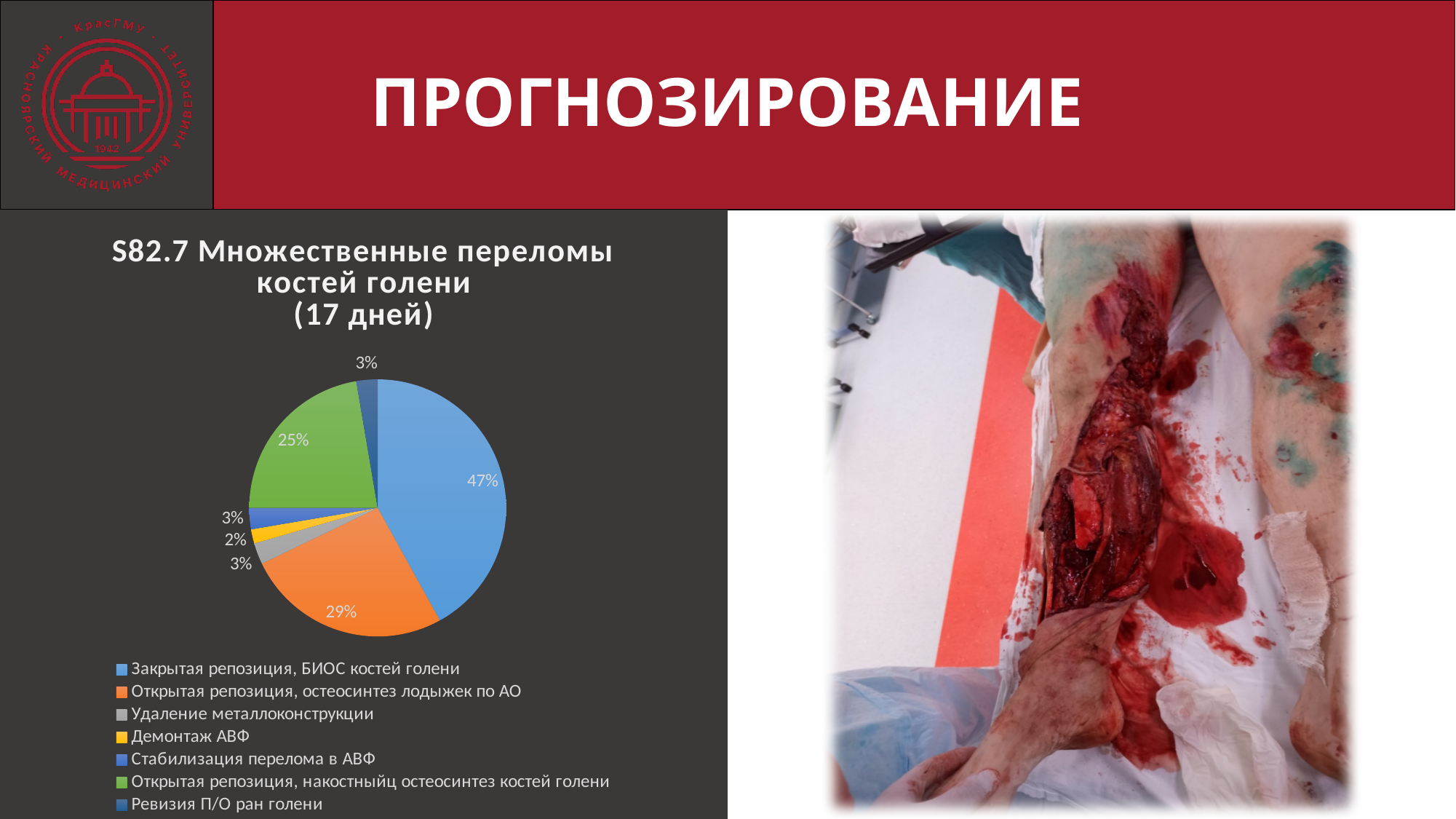
What share of the pie does "Демонтаж АВФ" have? 2% Which category has the smallest slice of the pie? Демонтаж АВФ What is the title of the pie chart? S82.7 Множественные переломы костей голени (17 дней) What share of the pie does "Открытая репозиция, остеосинтез лодыжек по АО" have? 29% What share of the pie does "Ревизия П/О ран голени" have? 3% Which is larger: the slice for "Открытая репозиция, остеосинтез лодыжек по АО" or the slice for "Открытая репозиция, накостныйц остеосинтез костей голени"? Открытая репозиция, остеосинтез лодыжек по АО How many categories does the legend of the pie chart list? 7 What is the difference in percentage points between "Закрытая репозиция, БИОС костей голени" and "Открытая репозиция, остеосинтез лодыжек по АО"? 18 Which category has the largest slice of the pie? Закрытая репозиция, БИОС костей голени What kind of chart is shown on the slide? pie chart